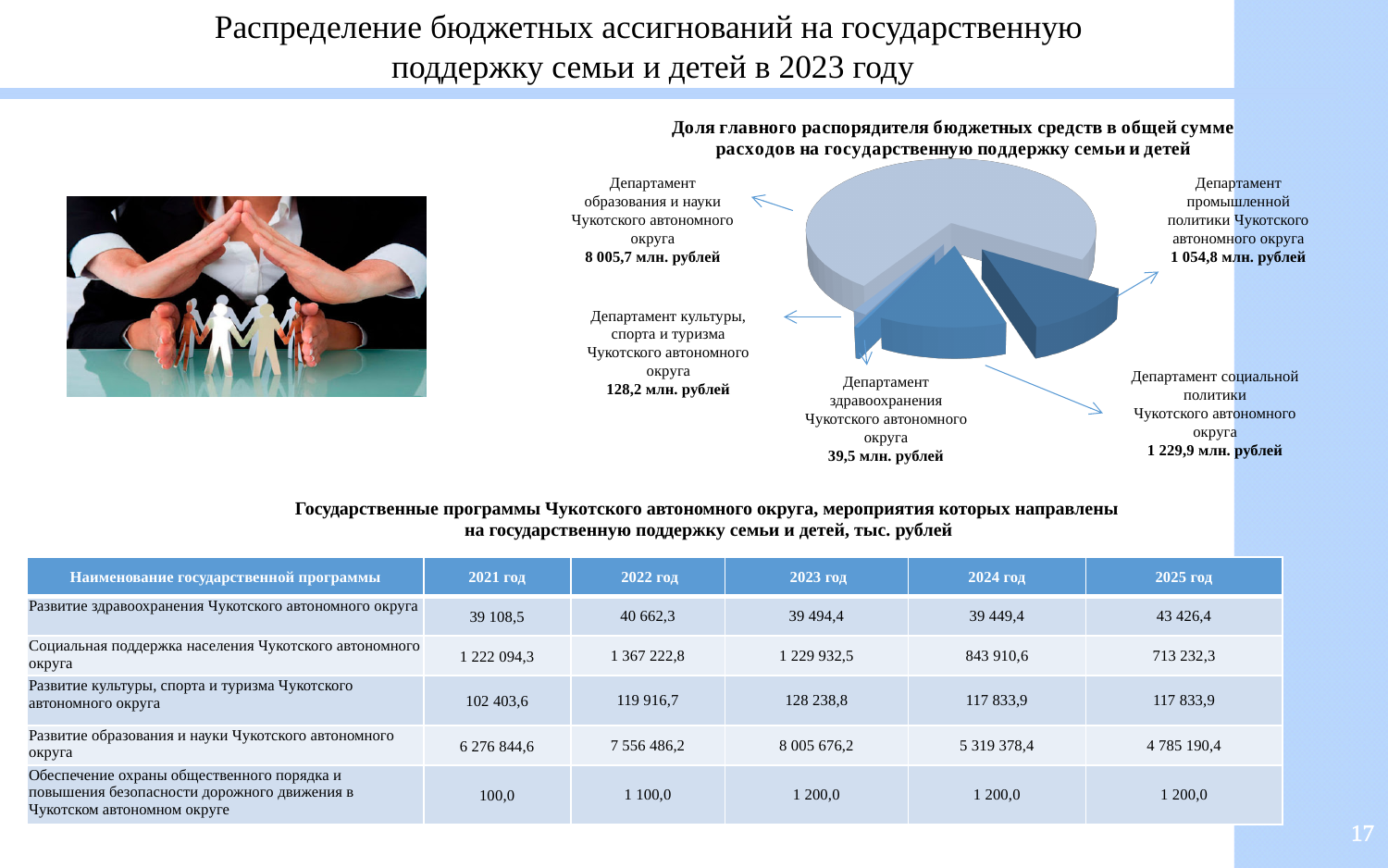
What kind of chart is shown on the slide? pie chart What is the value for Департамент культуры, спорта и туризма Чукотского автономного округа in the pie chart? 128,2 млн. рублей How many slices (departments) does the pie chart show? 5 Which is larger in the pie chart: Департамент социальной политики or Департамент промышленной политики? Департамент социальной политики What is the value for Департамент промышленной политики Чукотского автономного округа in the pie chart? 1 054,8 млн. рублей What is the value for Департамент здравоохранения Чукотского автономного округа in the pie chart? 39,5 млн. рублей What is the value for Департамент социальной политики Чукотского автономного округа in the pie chart? 1 229,9 млн. рублей What is the difference between the values for Департамент социальной политики and Департамент промышленной политики in the pie chart? 175,1 млн. рублей What is the value for Департамент образования и науки Чукотского автономного округа in the pie chart? 8 005,7 млн. рублей What is the title of the pie chart? Доля главного распорядителя бюджетных средств в общей сумме расходов на государственную поддержку семьи и детей Which department has the largest share in the pie chart? Департамент образования и науки Чукотского автономного округа Which department has the smallest share in the pie chart? Департамент здравоохранения Чукотского автономного округа